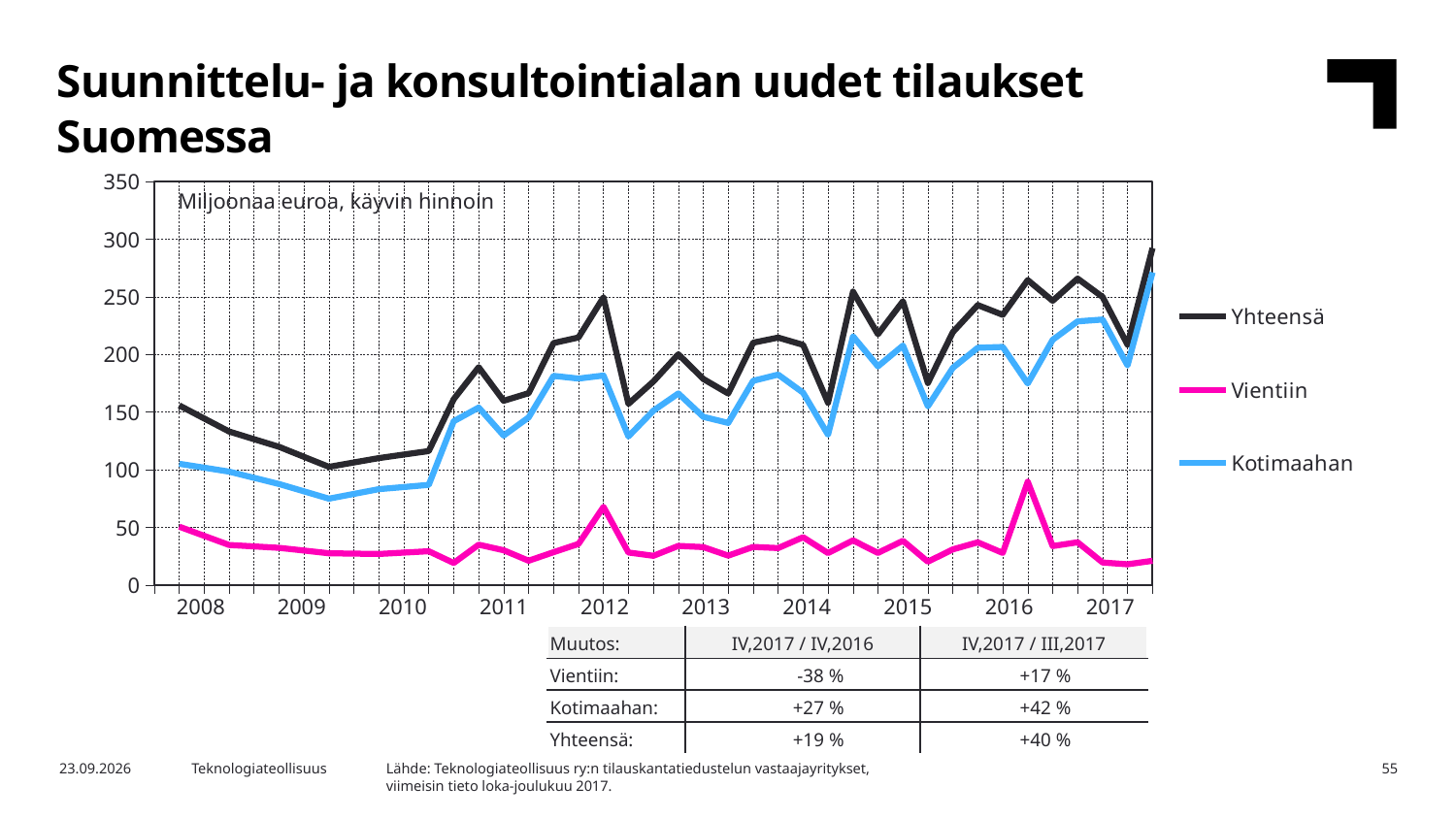
Is the lowest value for Kotimaahan in 2009 greater or less than 100? less Which series has the highest values throughout the chart? Yhteensä What are the three series named in the legend? Yhteensä, Vientiin, Kotimaahan How many series does the legend list? 3 Is the value for Yhteensä at the last point in 2017 greater or less than 250? greater What unit is stated in the chart's annotation? Miljoonaa euroa, käyvin hinnoin Does the Yhteensä line rise or fall from 2009 to the start of 2012? rise Which is larger in 2015, Kotimaahan or Vientiin? Kotimaahan What kind of chart is shown on the slide? line chart Is the peak value for Vientiin in 2016 greater or less than 50? greater Which series has the lowest values throughout the chart? Vientiin How many year labels are shown on the x axis? 10